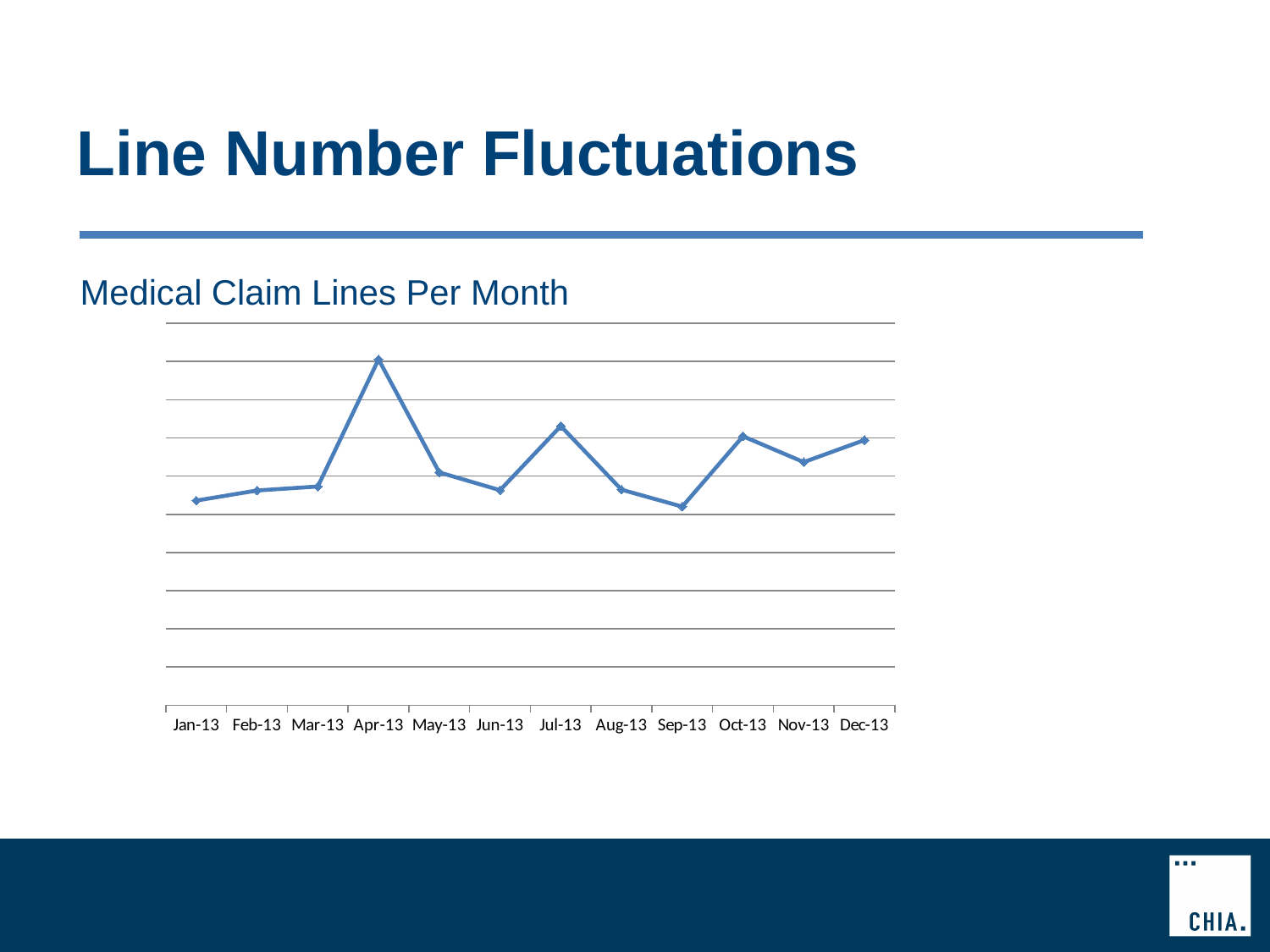
Which month has the highest value in the chart? Apr-13 Which is higher, the value for Oct-13 or the value for Nov-13? Oct-13 How many months are plotted along the x axis of the chart? 12 What colour is the plotted line in the chart? Blue Do the values rise or fall from Nov-13 to Dec-13? Rise Which is higher, the value for Aug-13 or the value for Sep-13? Aug-13 Do the values rise or fall from Apr-13 to Jun-13? Fall Which is higher, the value for Apr-13 or the value for Jul-13? Apr-13 What is the title of the chart? Medical Claim Lines Per Month What kind of chart is shown on the slide? Line chart Do the values rise or fall from Jan-13 to Apr-13? Rise